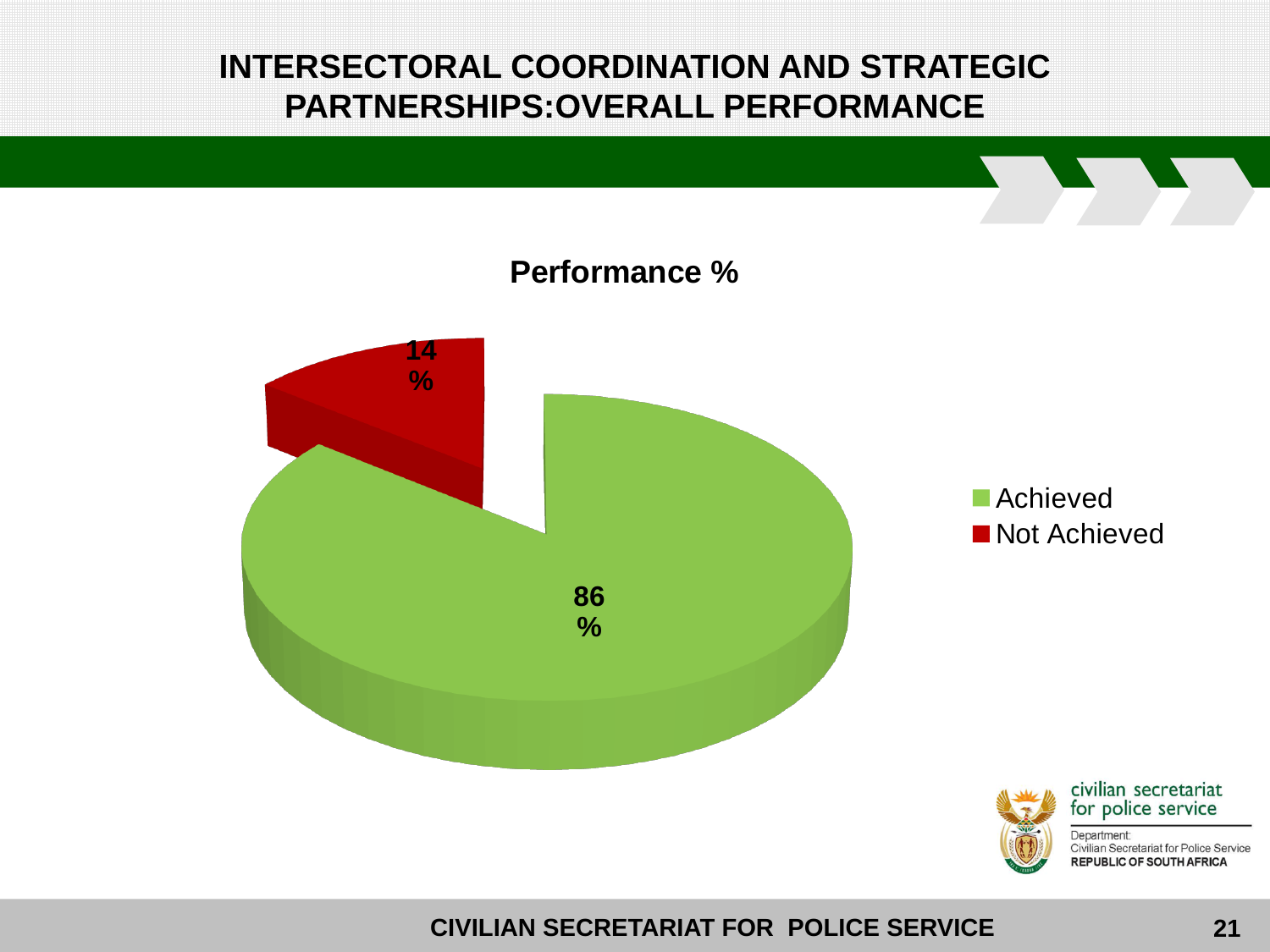
What share of the pie does the Achieved slice represent? 86% What is the title of the chart? Performance % Which category has the smallest share of the pie chart? Not Achieved What percentage of the pie chart is labelled Achieved? 86% What colour is the Not Achieved slice? Red What is the difference in percentage points between the Achieved and Not Achieved slices? 72 How many slices does the pie chart have? 2 Which is larger, the Achieved slice or the Not Achieved slice? Achieved What kind of chart is shown on the slide? Pie chart What percentage of the pie chart is labelled Not Achieved? 14% Which category has the largest share of the pie chart? Achieved How many entries does the legend list? 2